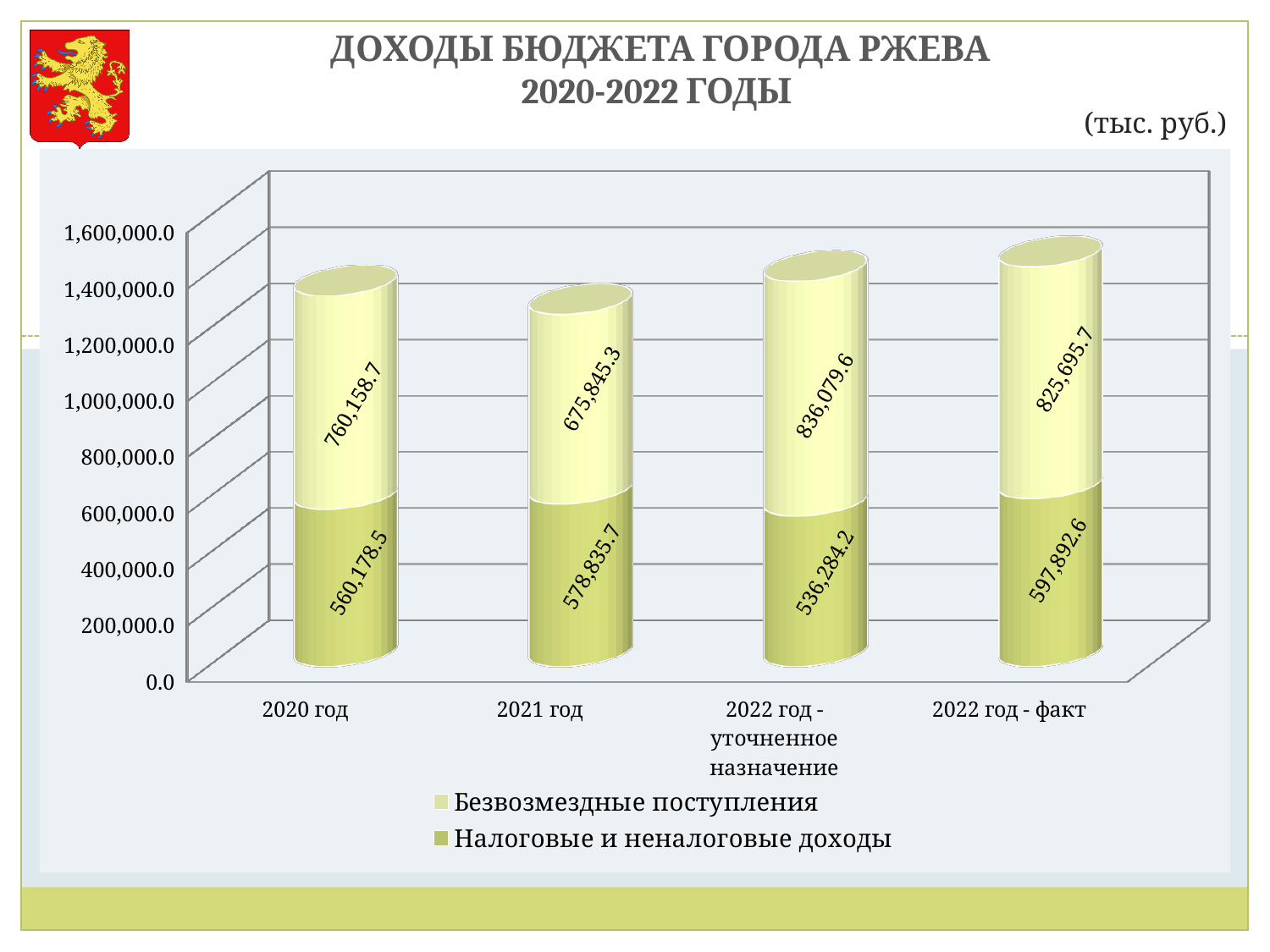
How many categories are shown on the x axis? 4 How many series does the legend list? 2 Which is larger: Налоговые и неналоговые доходы for 2022 год - факт or for 2022 год - уточненное назначение? 2022 год - факт What is the total of the stacked bar for 2021 год? 1,254,681.0 Which category has the lowest value for Налоговые и неналоговые доходы? 2022 год - уточненное назначение What is the difference between Безвозмездные поступления for 2020 год and 2021 год? 84,313.4 What is the value of Налоговые и неналоговые доходы for 2021 год? 578,835.7 What is the value of Налоговые и неналоговые доходы for 2022 год - факт? 597,892.6 What is the value of Безвозмездные поступления for 2020 год? 760,158.7 Which category has the highest value for Безвозмездные поступления? 2022 год - уточненное назначение What is the total of the stacked bar for 2022 год - факт? 1,423,588.3 What kind of chart is shown on the slide? Stacked bar chart